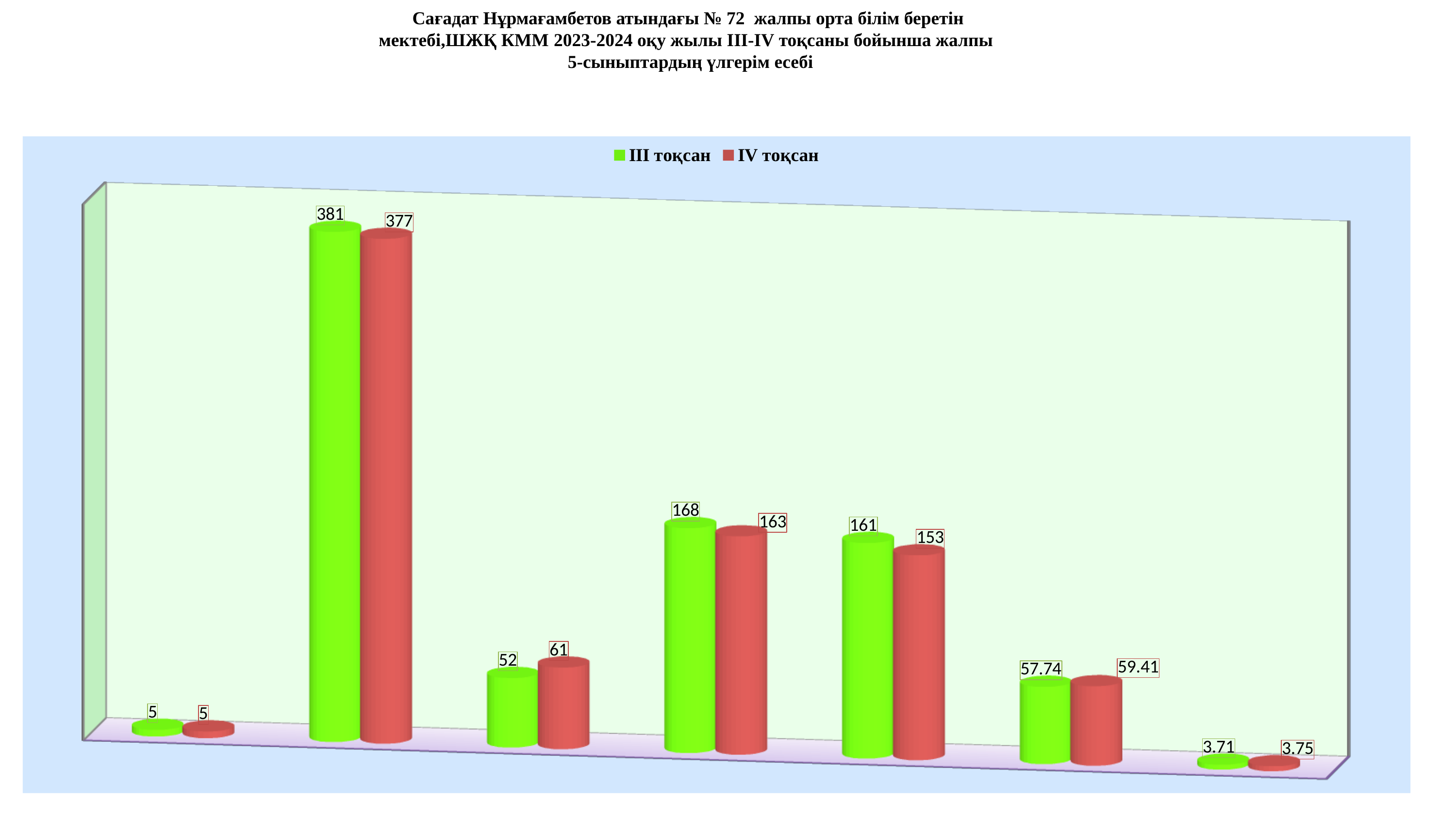
How many groups of bars are plotted in the chart? 7 What is the IV тоқсан value in the third group of bars from the left? 61 How many series does the legend list? 2 What are the two series named in the legend? III тоқсан and IV тоқсан What is the IV тоқсан value for the second (tallest) group of bars? 377 What is the III тоқсан value in the sixth group of bars from the left? 57.74 What is the III тоқсан value for the second (tallest) group of bars? 381 What is the difference between the III тоқсан and IV тоқсан values in the tallest group of bars? 4 Which series is shown in green? III тоқсан What kind of chart is shown on the slide? bar chart In the third group of bars from the left, which series has the larger value, III тоқсан or IV тоқсан? IV тоқсан What is the IV тоқсан value in the rightmost group of bars? 3.75